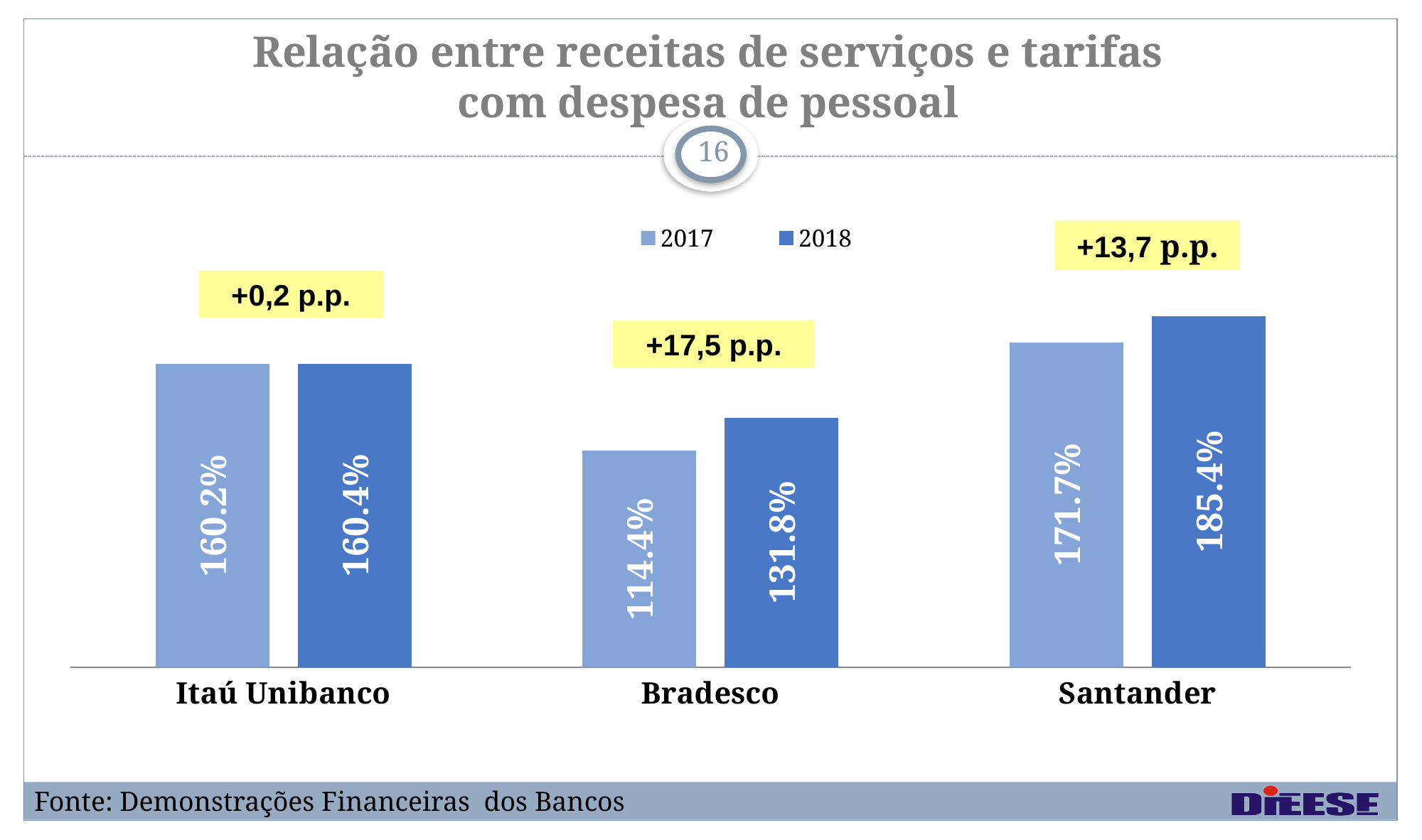
Which is larger: Bradesco's 2018 value or Itaú Unibanco's 2017 value? Itaú Unibanco's 2017 value What is the difference between Santander's 2018 and 2017 values, in percentage points? 13.7 What change in percentage points is annotated above the Bradesco bars? +17,5 p.p. What is the value for Bradesco in 2017? 114.4% How many banks are shown on the x axis? 3 What is the value for Itaú Unibanco in 2017? 160.2% Which bank has the lowest value in 2017? Bradesco Which bank has the highest value in 2018? Santander How many series does the legend list? 2 What is the value for Santander in 2018? 185.4% What is the difference between Bradesco's 2018 and 2017 values, in percentage points? 17.4 What kind of chart is shown on the slide? Bar chart